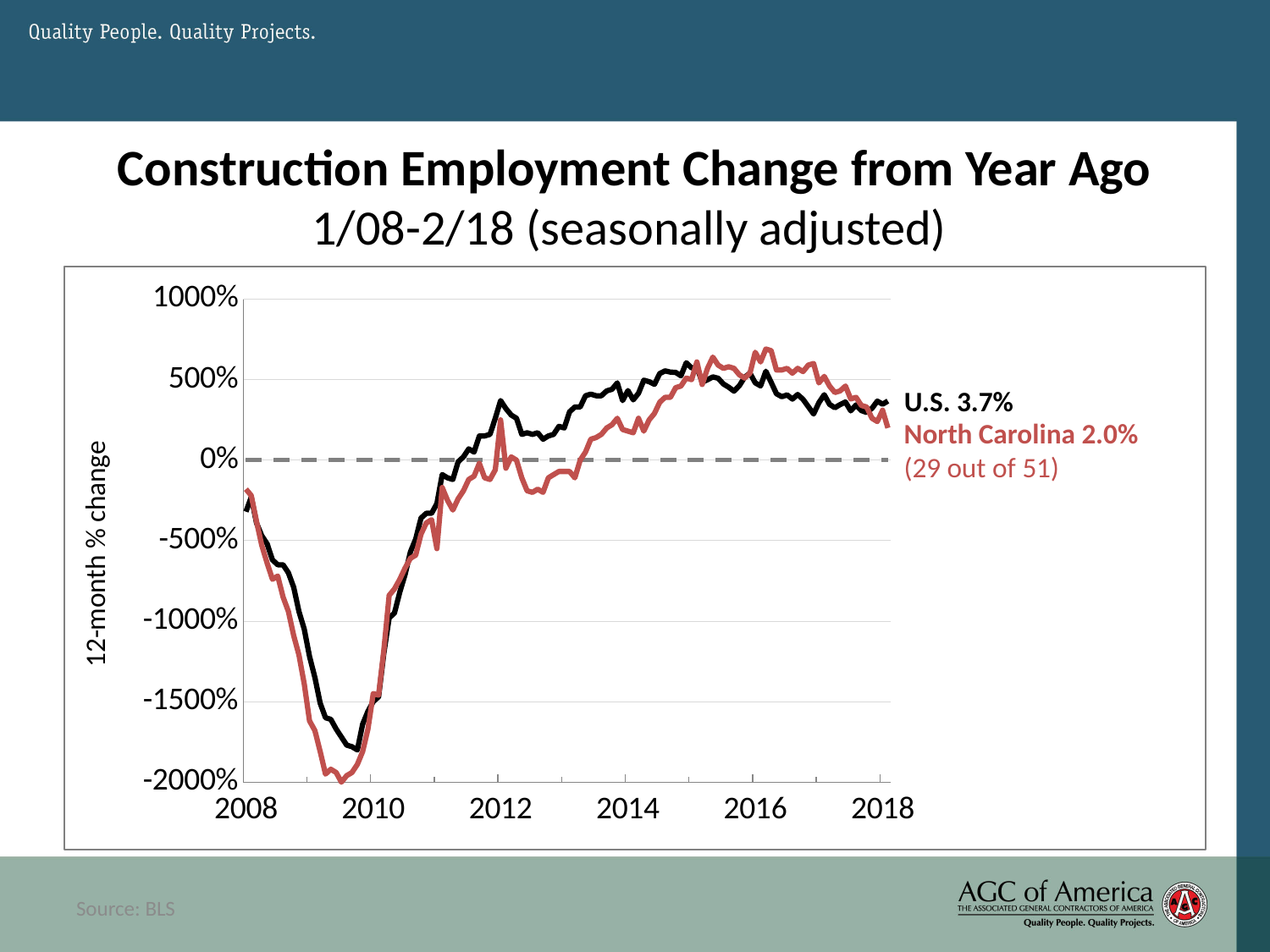
Is the peak value of the North Carolina line around 2016 greater or less than 500%? greater Is the lowest value of the North Carolina line around 2009 greater or less than -1500%? less What is the latest value shown for the U.S. series? 3.7% What kind of chart is shown on the slide? line chart What is the difference between the latest U.S. value (3.7%) and the latest North Carolina value (2.0%)? 1.7% What rank is given for North Carolina on the chart? 29 out of 51 Which has the larger latest value, the U.S. or North Carolina? U.S. Which series reaches the lower minimum around 2009, the U.S. or North Carolina? North Carolina What is the label on the vertical axis of the chart? 12-month % change How many series are plotted on the chart? 3 Do the values rise or fall between 2008 and 2009? fall What is the latest value shown for the North Carolina series? 2.0%